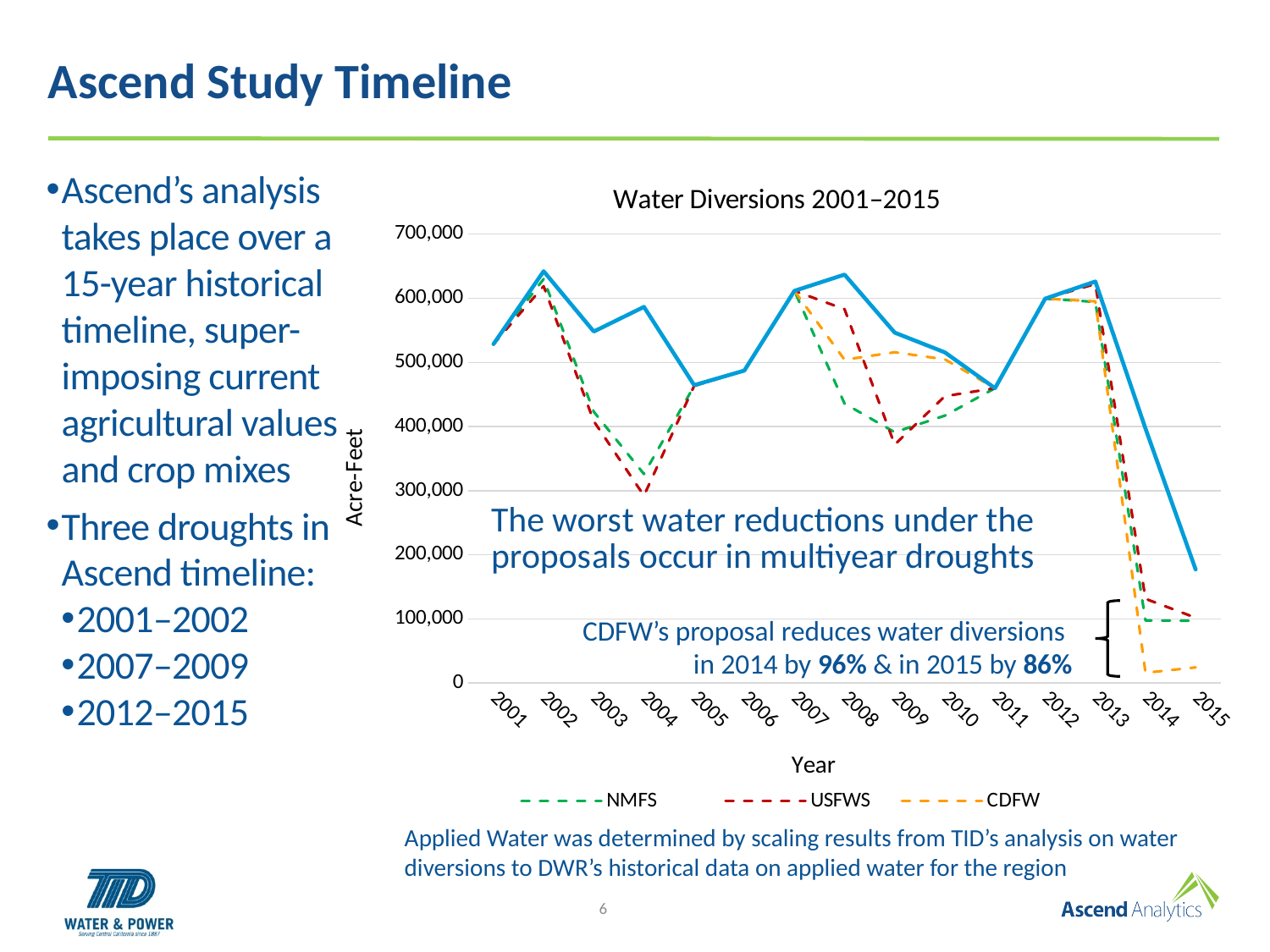
How many series does the chart's legend list? 3 Is the USFWS value for 2014 greater or less than 100,000? greater Is the USFWS value for 2009 greater or less than 400,000? less What is the title of the chart? Water Diversions 2001–2015 What is the label of the y axis of the chart? Acre-Feet What type of chart is shown on the slide? line chart Do the values of the CDFW series rise or fall from 2013 to 2014? fall Is the CDFW value for 2014 greater or less than 100,000? less How many years are plotted along the x axis of the chart? 15 In which year does the CDFW series reach its lowest value? 2014 In 2014, which series has the higher value, USFWS or CDFW? USFWS